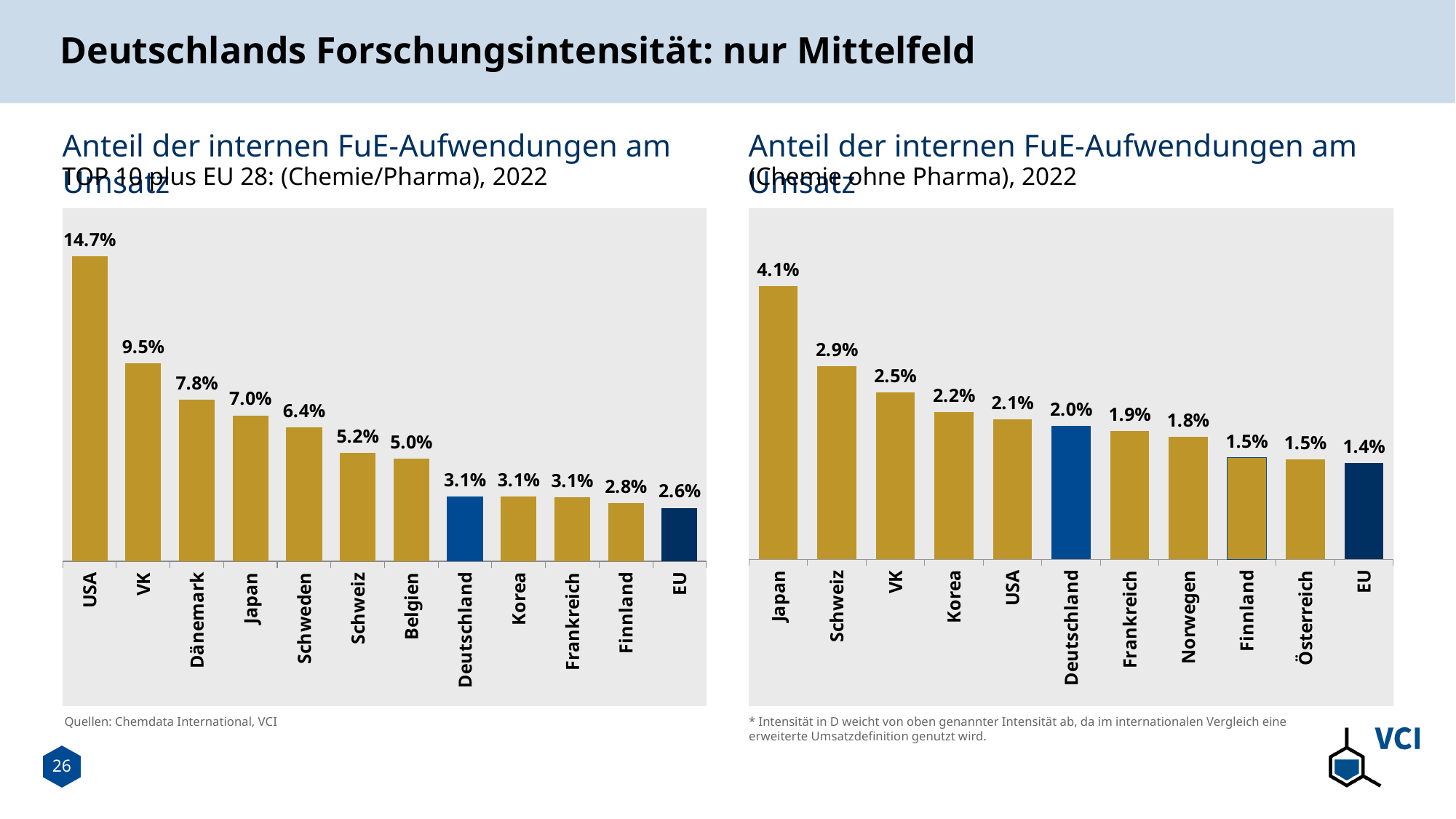
What type of chart is the left chart (Chemie/Pharma)? Bar chart In the left chart (Chemie/Pharma), what is the value for USA? 14.7% In the left chart (Chemie/Pharma), what is the value for Deutschland? 3.1% In the left chart (Chemie/Pharma), which is larger, the value for Schweden or the value for Belgien? Schweden In the left chart (Chemie/Pharma), what is the difference between the values for USA and VK? 5.2% In the right chart (Chemie ohne Pharma), what is the difference between the values for Schweiz and EU? 1.5% In the right chart (Chemie ohne Pharma), what is the value for Deutschland? 2.0% In the left chart (Chemie/Pharma), how many bars are shown? 12 In the right chart (Chemie ohne Pharma), how many bars are shown? 11 In the left chart (Chemie/Pharma), which category has the lowest value? EU In the right chart (Chemie ohne Pharma), what is the value for Japan? 4.1% In the right chart (Chemie ohne Pharma), which category has the highest value? Japan